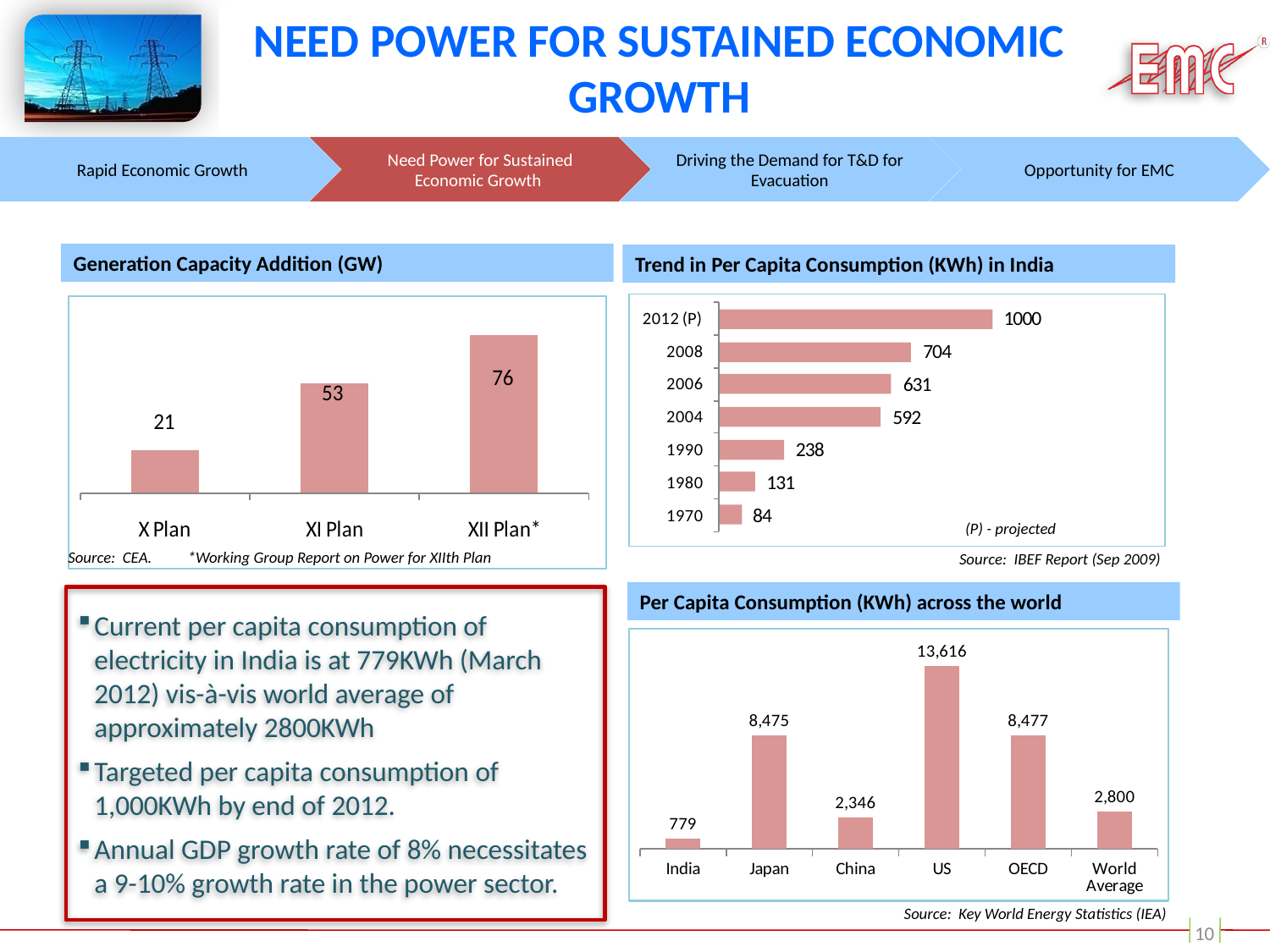
In the Generation Capacity Addition (GW) chart, what is the difference between XII Plan* and X Plan? 55 In the Per Capita Consumption (KWh) across the world chart, which category has the highest value? US In the Generation Capacity Addition (GW) chart, how many plans are shown? 3 In the Generation Capacity Addition (GW) chart, which plan has the highest value? XII Plan* In the Trend in Per Capita Consumption (KWh) in India chart, what is the value for 2004? 592 In the Trend in Per Capita Consumption (KWh) in India chart, how many years are shown? 7 What type of chart is the Per Capita Consumption (KWh) across the world chart? Bar chart In the Per Capita Consumption (KWh) across the world chart, what is the value for China? 2,346 In the Trend in Per Capita Consumption (KWh) in India chart, what is the difference between 2008 and 2006? 73 In the Generation Capacity Addition (GW) chart, what is the value for XI Plan? 53 In the Trend in Per Capita Consumption (KWh) in India chart, which year has the lowest value? 1970 In the Per Capita Consumption (KWh) across the world chart, is the value for Japan or OECD larger? OECD